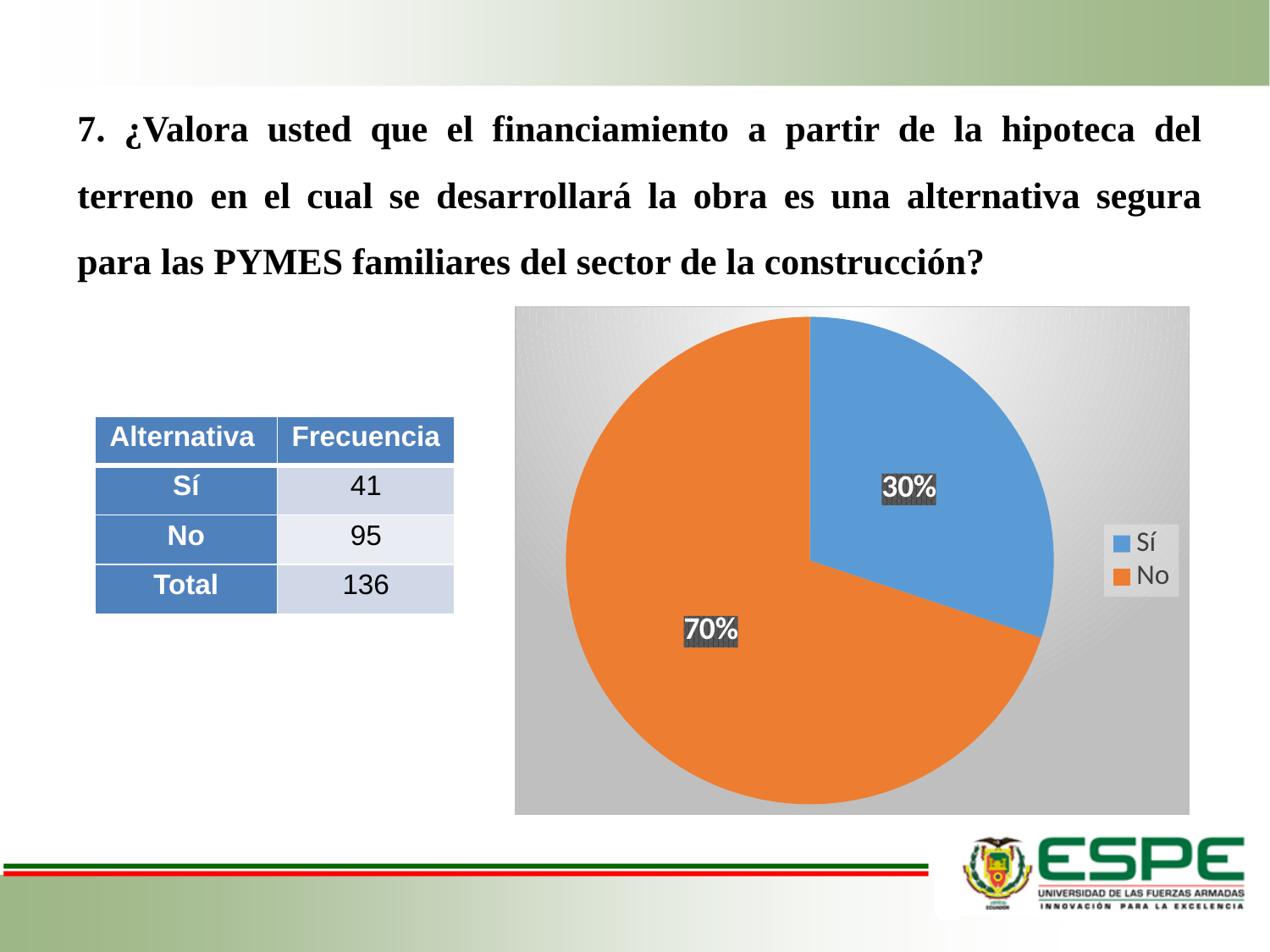
How many slices does the pie chart have? 2 Which slice of the pie is the smallest? Sí What share of the pie does the "No" slice represent? 70% Which slice of the pie is the largest? No What colour is the "Sí" slice in the pie chart? blue What is the difference in percentage points between the "No" slice and the "Sí" slice? 40% What colour is the "No" slice in the pie chart? orange How many entries does the legend of the pie chart list? 2 What kind of chart is shown on the slide? pie chart What share of the pie does the "Sí" slice represent? 30% Which is larger in the pie chart, the "Sí" slice or the "No" slice? No